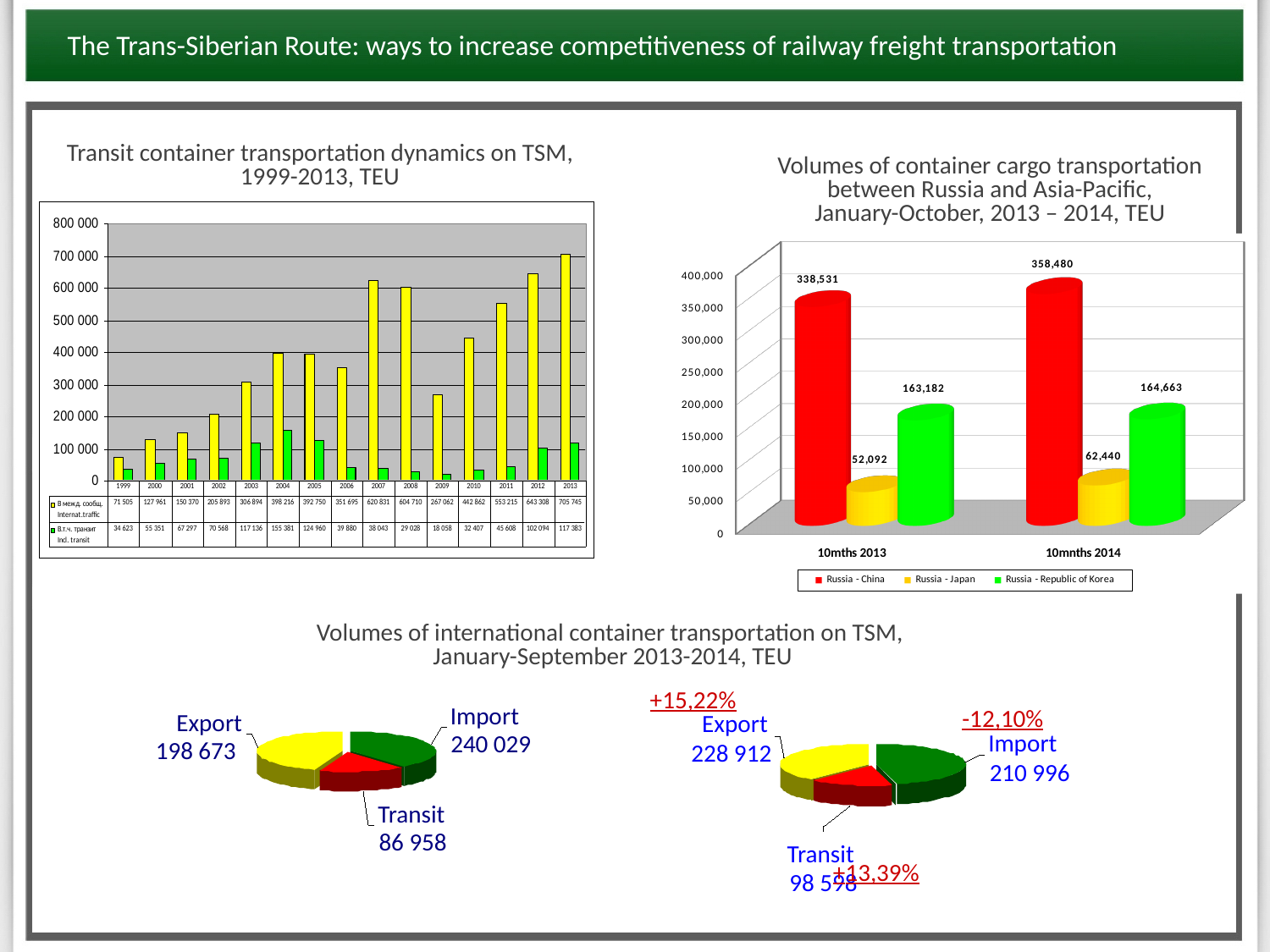
In the left pie chart under 'Volumes of international container transportation on TSM, January-September 2013-2014, TEU', what is the Import value? 240 029 In the chart 'Transit container transportation dynamics on TSM, 1999-2013, TEU', what is the Incl. transit value for 2004? 155 381 In the chart 'Transit container transportation dynamics on TSM, 1999-2013, TEU', how many years are shown on the x axis? 15 In the chart 'Transit container transportation dynamics on TSM, 1999-2013, TEU', is the Internat. traffic value for 2009 greater or less than 300 000? less In the chart 'Volumes of container cargo transportation between Russia and Asia-Pacific', what is the value for Russia - China in 10mths 2013? 338,531 In the right pie chart under 'Volumes of international container transportation on TSM, January-September 2013-2014, TEU', which is larger, Export or Import? Export In the chart 'Volumes of container cargo transportation between Russia and Asia-Pacific', which series has the highest value in 10mnths 2014? Russia - China In the chart 'Volumes of container cargo transportation between Russia and Asia-Pacific', what is the difference between Russia - China in 10mnths 2014 and 10mths 2013? 19,949 In the chart 'Volumes of container cargo transportation between Russia and Asia-Pacific', what is the value for Russia - Japan in 10mnths 2014? 62,440 In the chart 'Volumes of container cargo transportation between Russia and Asia-Pacific', which series has the lowest value in 10mths 2013? Russia - Japan In the chart 'Volumes of container cargo transportation between Russia and Asia-Pacific', how many series does the legend list? 3 In the chart 'Transit container transportation dynamics on TSM, 1999-2013, TEU', what is the Internat. traffic value for 2013? 705 745